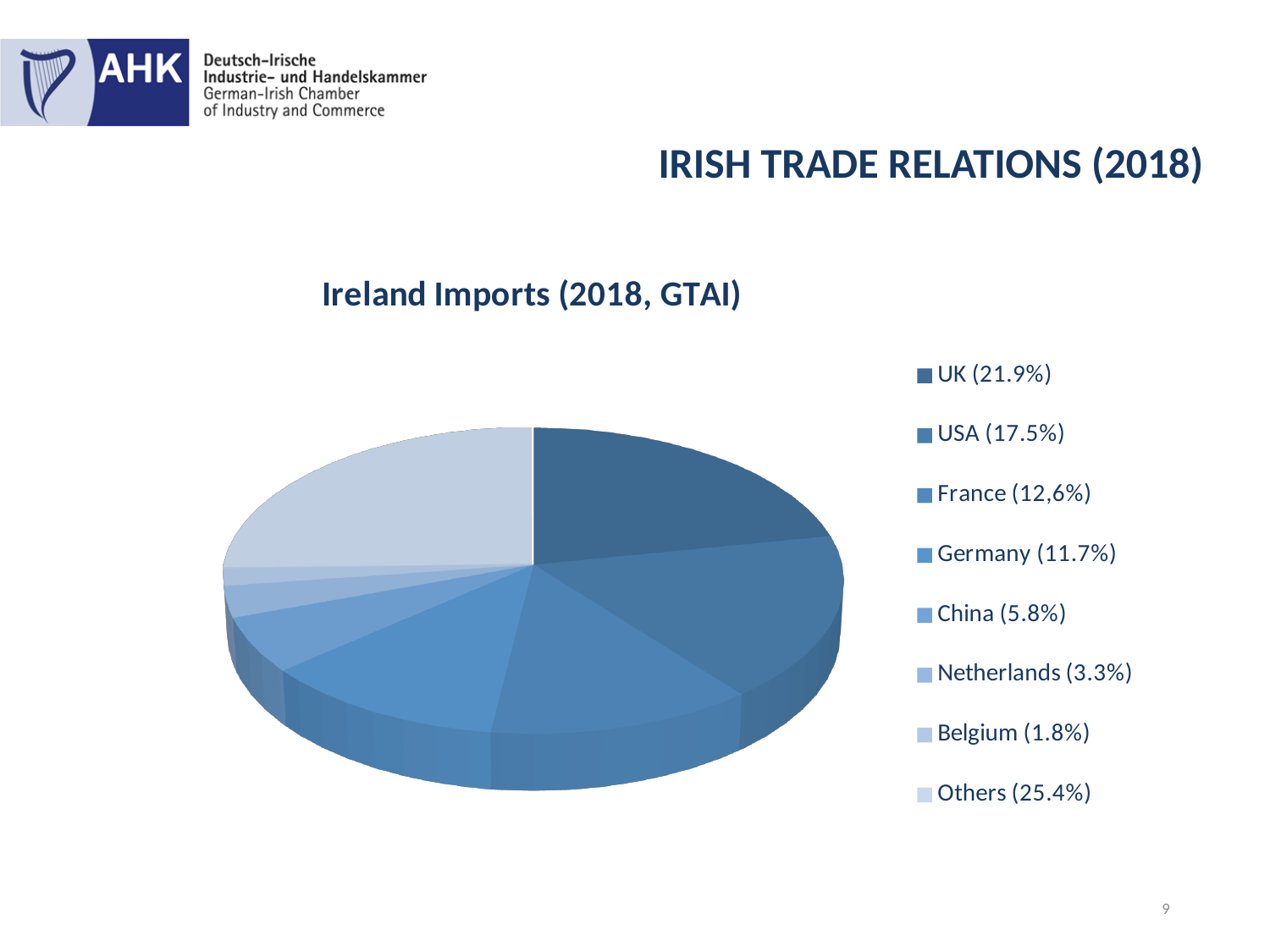
Which named country has the largest share of Ireland's imports? UK What kind of chart is shown on the slide? Pie chart How many slices does the pie chart have? 8 Which legend entry has the largest share of the pie? Others (25.4%) Which is larger, the share for France or the share for Germany? France What value is shown for the Netherlands? 3.3% What is the title of the chart? Ireland Imports (2018, GTAI) What percentage is shown for Germany in the legend? 11.7% What is the difference between Germany's share and China's share? 5.9% Which legend entry has the smallest share of the pie? Belgium (1.8%) What share of Ireland's imports does the UK account for? 21.9% How many percentage points larger is the UK's share than the USA's share? 4.4%